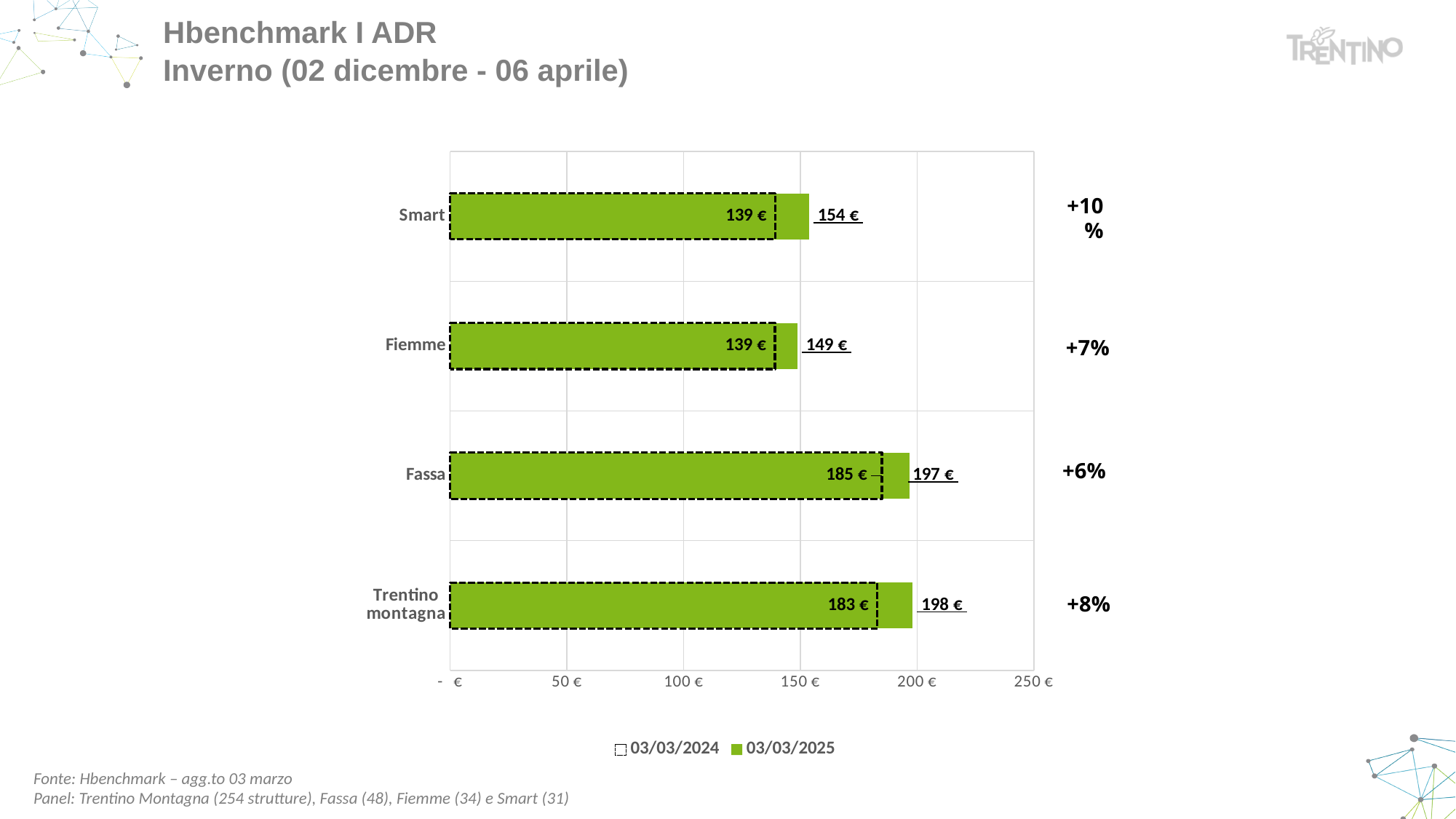
What kind of chart is shown on the slide? Bar chart Which category has the highest value in the 03/03/2025 series? Trentino montagna How many categories are shown on the chart? 4 Which is larger: the 03/03/2025 value for Fassa or for Trentino montagna? Trentino montagna What is the ADR value for Fassa in the 03/03/2024 series? 185 € How many series does the legend list? 2 What is the difference between the 03/03/2025 and 03/03/2024 values for Smart? 15 € What is the ADR value for Trentino montagna in the 03/03/2025 series? 198 € What is the difference between the 03/03/2025 values for Fassa and Fiemme? 48 € Is the 03/03/2024 value for Fiemme greater or less than 150 €? less What is the ADR value for Smart in the 03/03/2025 series? 154 € Which category has the lowest value in the 03/03/2025 series? Fiemme